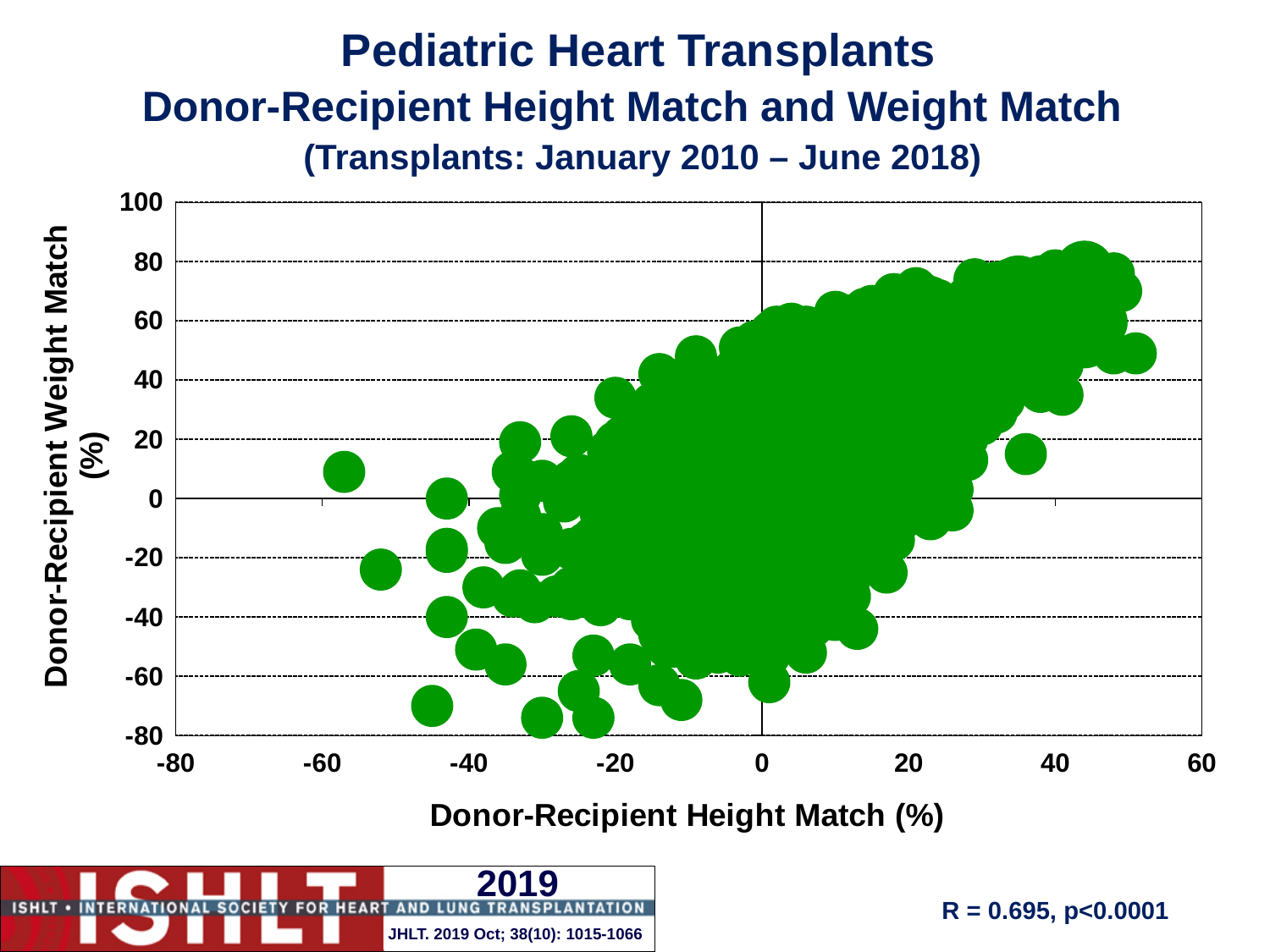
What kind of chart is shown on the slide? scatter chart Is the weight match value of the lowest point greater or less than -60? less What is the label of the y axis? Donor-Recipient Weight Match (%) Is the height match value of the rightmost point greater or less than 40? greater As Donor-Recipient Height Match increases along the x axis, does Donor-Recipient Weight Match tend to rise or fall? rise Is the height match value of the leftmost point greater or less than -40? less What correlation coefficient R is reported on the slide? R = 0.695